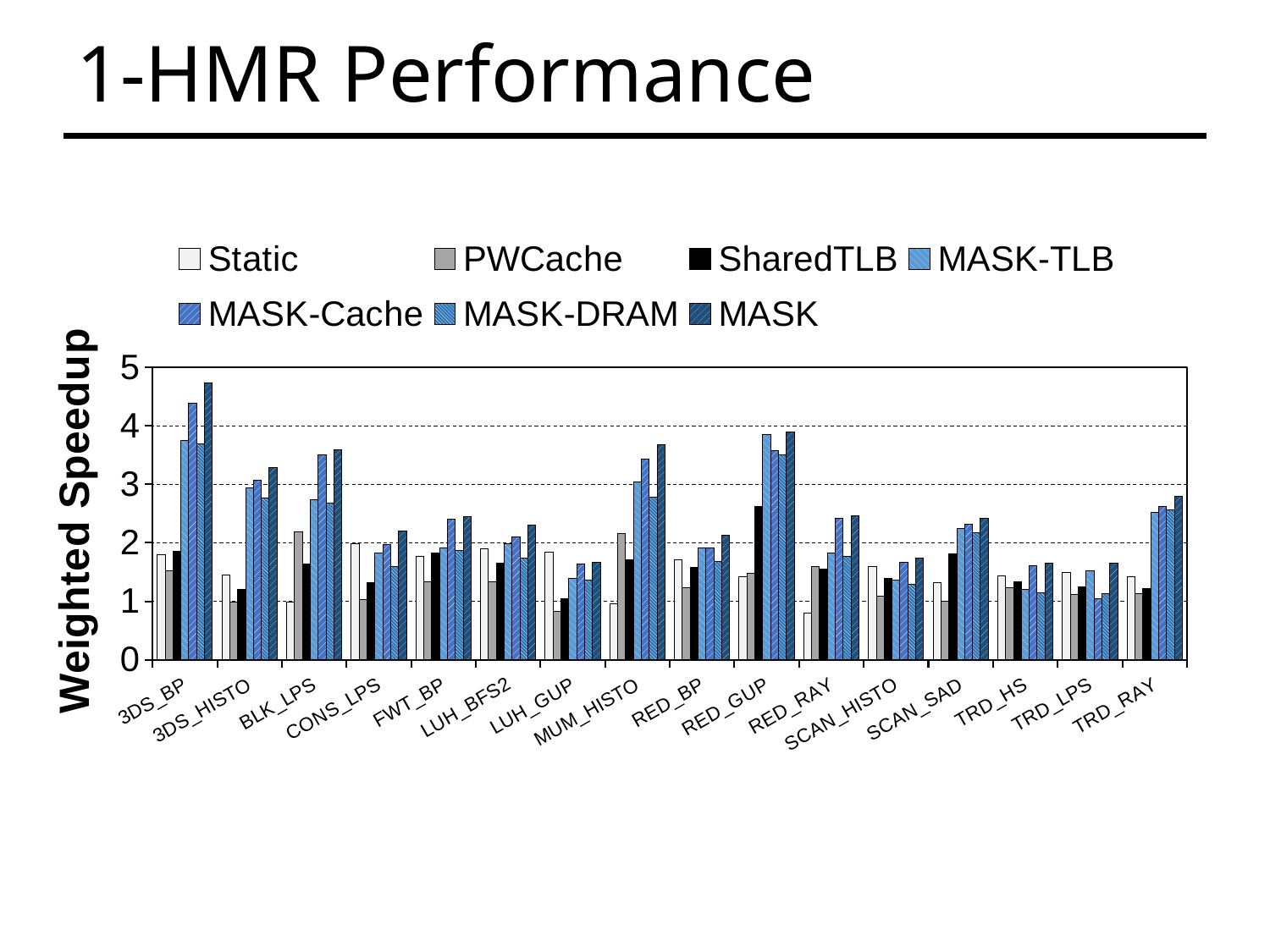
Is the Static value for 3DS_HISTO greater or less than 2? less What is the label of the y axis? Weighted Speedup Which is larger, the MASK value for 3DS_BP or the MASK value for TRD_HS? 3DS_BP What kind of chart is shown on the slide? bar chart Which is larger, the MASK value for MUM_HISTO or the MASK value for RED_BP? MUM_HISTO Is the MASK value for 3DS_BP greater or less than 4? greater Which series is listed last in the legend? MASK Is the MASK value for RED_GUP greater or less than 3? greater How many workload categories are shown on the x axis? 16 How many series does the legend list? 7 For which category is the MASK bar the highest? 3DS_BP